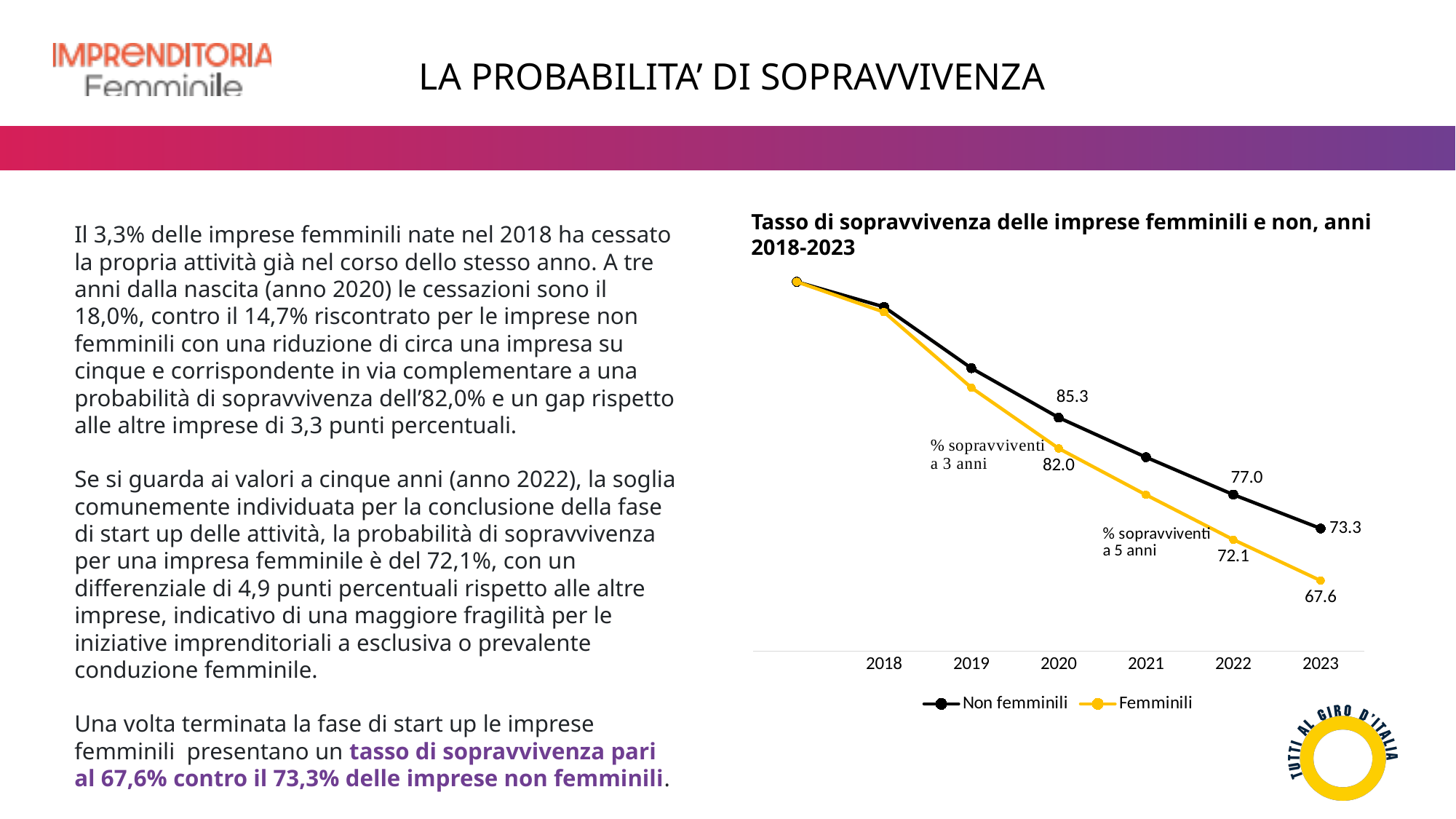
What is the difference between the Non femminili and Femminili values in 2023? 5.7 What is the value for Non femminili in 2022? 77.0 What is the value for Femminili in 2022? 72.1 Do the Femminili values rise or fall from 2018 to 2023? fall What is the value for Femminili in 2020? 82.0 What kind of chart is shown on the slide? line chart Which series has the higher value in 2022, Non femminili or Femminili? Non femminili What is the value for Non femminili in 2023? 73.3 What is the value for Femminili in 2023? 67.6 How many series does the legend list? 2 What is the value for Non femminili in 2020? 85.3 What is the difference between the Non femminili and Femminili values in 2022? 4.9